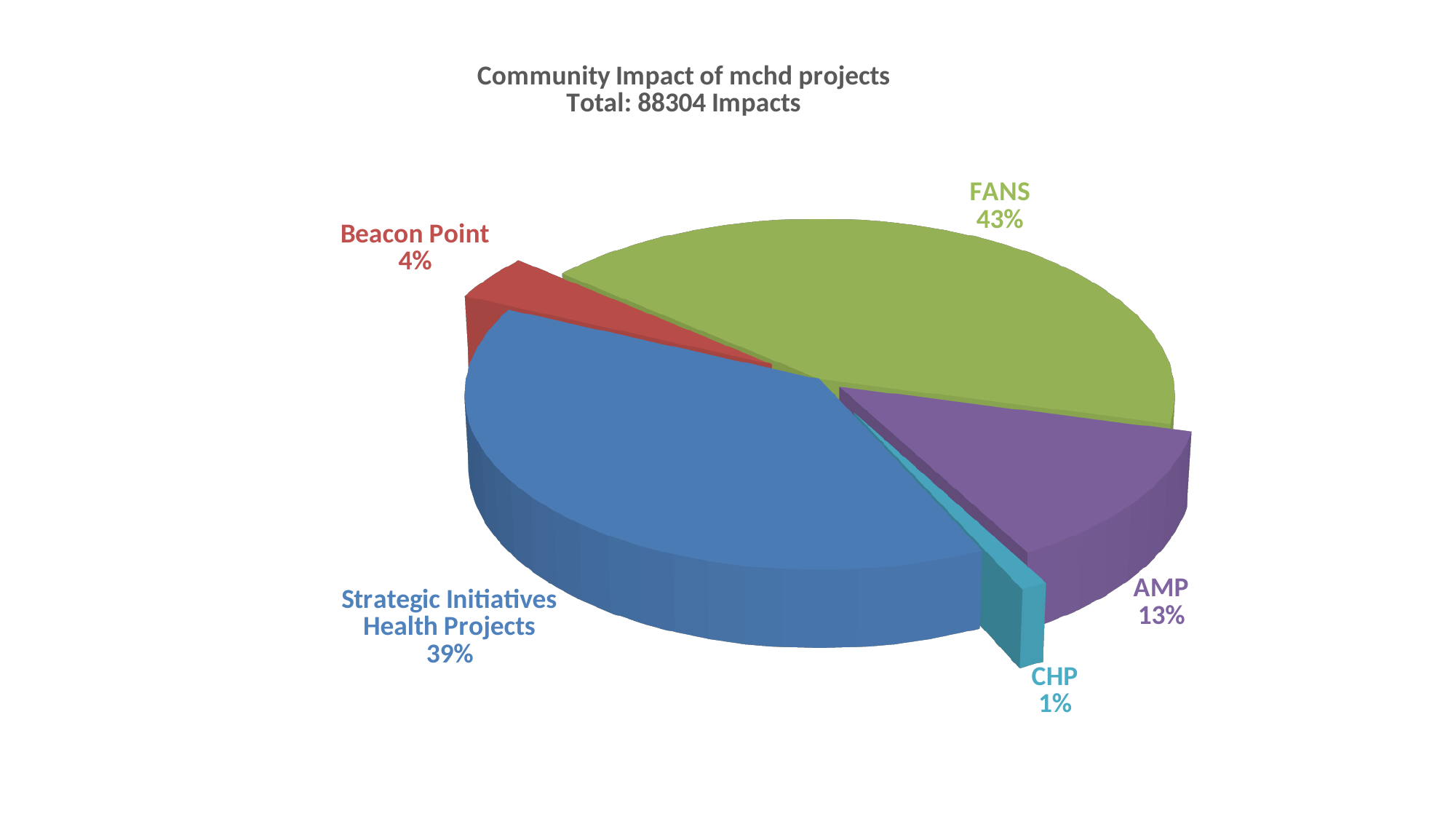
What percentage is shown for CHP? 1% What share of the pie does Strategic Initiatives Health Projects represent? 39% What percentage is shown for AMP? 13% What kind of chart is shown on the slide? Pie chart Which category has the smallest share of the pie? CHP What is the difference in percentage points between FANS and AMP? 30 Which category has the largest share of the pie? FANS How many categories are shown in the pie chart? 5 What share of the pie does FANS represent? 43% Which is larger, the share for AMP or the share for Beacon Point? AMP What percentage is shown for Beacon Point? 4% What total number of impacts is stated in the chart title? 88304